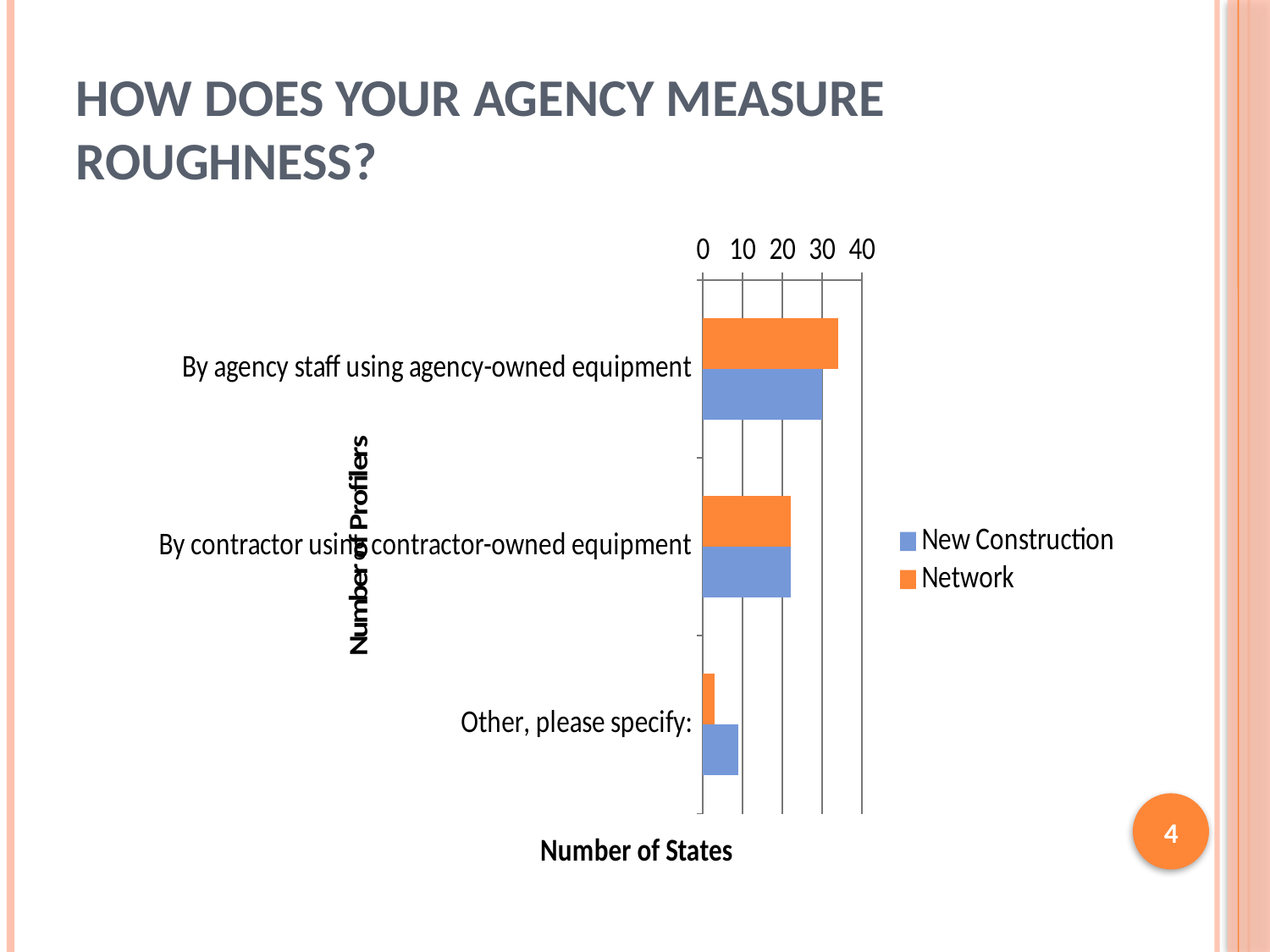
What kind of chart is shown on the slide? bar chart For 'Other, please specify:', which series has the larger value, New Construction or Network? New Construction Which series is shown in orange? Network What is the title of the horizontal axis? Number of States Which category has the lowest Network value? Other, please specify: How many series does the legend list? 2 Is the Network value for 'Other, please specify:' greater or less than 10? less Which category has the highest Network value? By agency staff using agency-owned equipment Which category has the lowest New Construction value? Other, please specify: Is the Network value for 'By contractor using contractor-owned equipment' greater or less than 30? less Is the Network value for 'By agency staff using agency-owned equipment' greater or less than 30? greater How many categories are plotted on the chart? 3